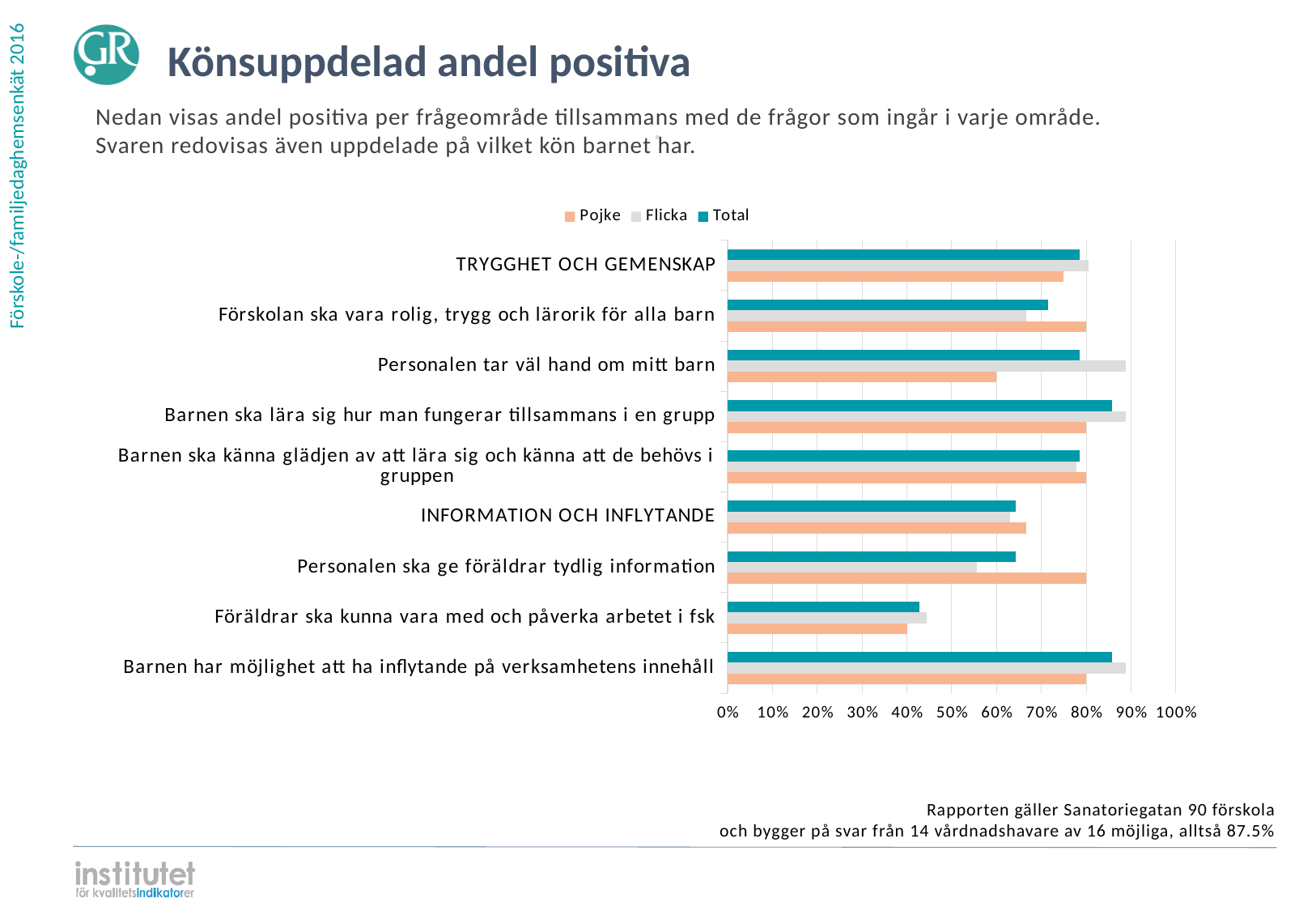
What is the Pojke value for 'Personalen tar väl hand om mitt barn'? 60% For 'Personalen ska ge föräldrar tydlig information', which is larger: the Pojke value or the Flicka value? Pojke How many categories are plotted on the chart? 9 For 'Personalen tar väl hand om mitt barn', which is larger: the Pojke value or the Flicka value? Flicka Is the Flicka value for 'Personalen tar väl hand om mitt barn' greater or less than 80%? greater What kind of chart is shown on the slide? bar chart What is the Pojke value for 'Föräldrar ska kunna vara med och påverka arbetet i fsk'? 40% Which category has the lowest Total value? Föräldrar ska kunna vara med och påverka arbetet i fsk What are the series named in the legend? Pojke, Flicka, Total How many series does the legend list? 3 Is the Pojke value for 'INFORMATION OCH INFLYTANDE' greater or less than 60%? greater Is the Total value for 'Föräldrar ska kunna vara med och påverka arbetet i fsk' greater or less than 50%? less